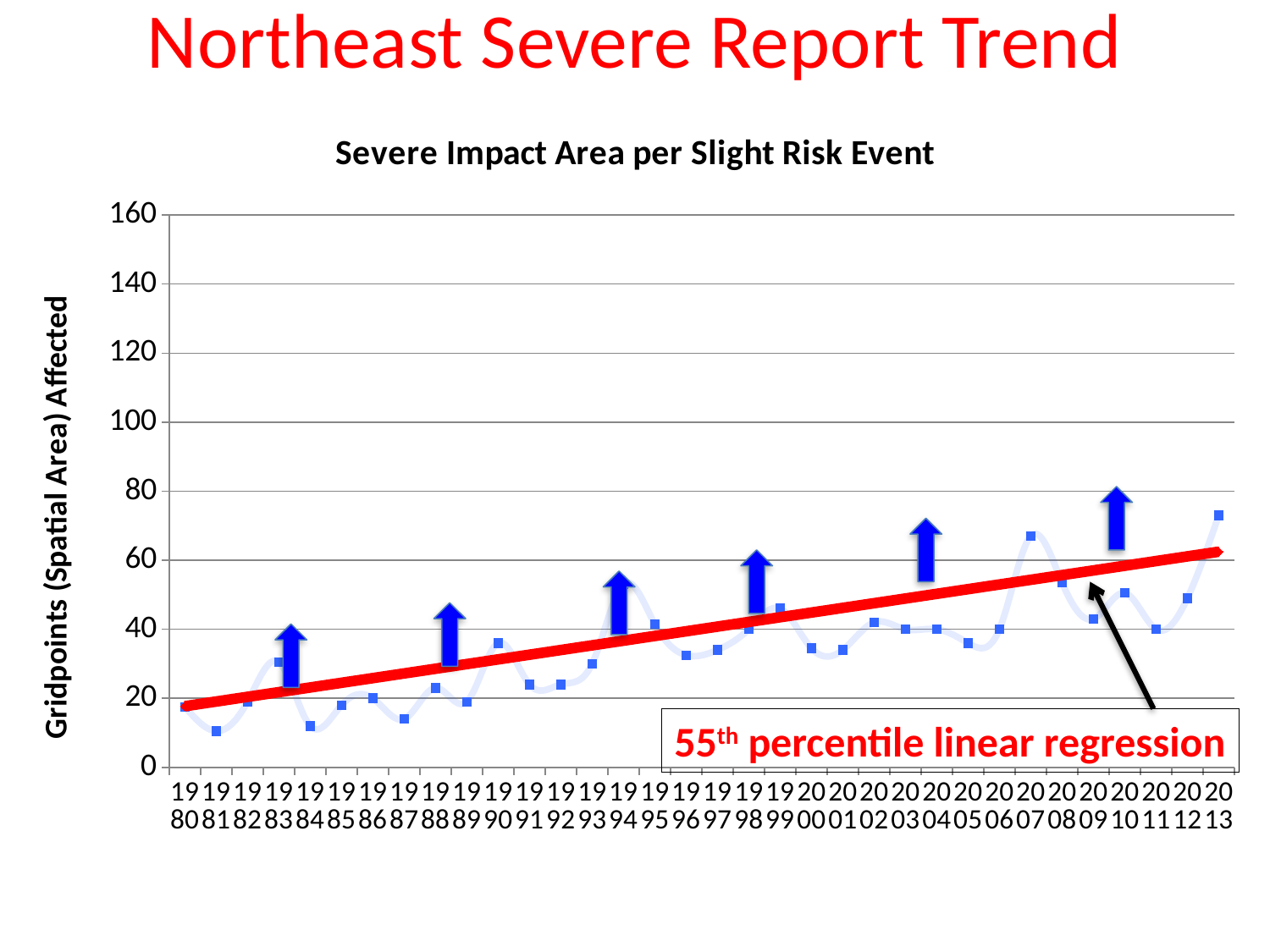
Is the value for 2013 greater or less than 60? greater Which year has the highest value on the chart? 2013 What is the title of the chart? Severe Impact Area per Slight Risk Event Is the value for 1981 greater or less than 20? less How many years (data points) are plotted along the x axis? 34 What does the red line on the chart represent, according to the label? 55th percentile linear regression Do the values generally rise or fall from 1980 to 2013? rise What type of chart is shown on the slide? line chart Which year has the larger value, 1980 or 2013? 2013 Is the value for 2007 greater or less than 60? greater Which year has the larger value, 2007 or 2008? 2007